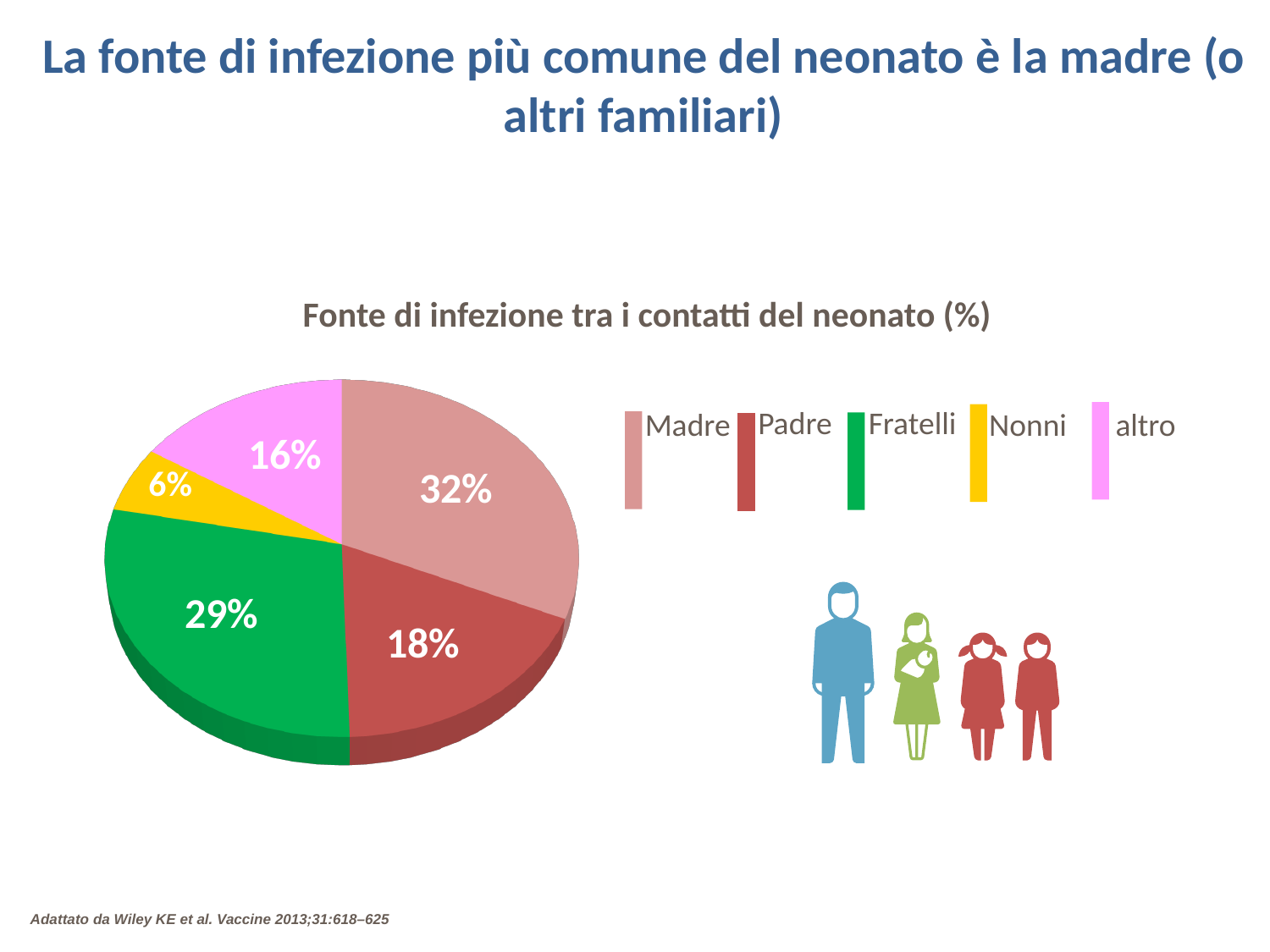
What percentage of the pie is attributed to Madre? 32% What percentage of the pie is attributed to Padre? 18% Which is larger, the share for Fratelli or the share for altro? Fratelli Which category has the largest share of the pie? Madre What type of chart is shown on the slide? Pie chart What percentage of the pie is attributed to Nonni? 6% Which category has the smallest share of the pie? Nonni What percentage of the pie is attributed to altro? 16% What is the chart's title? Fonte di infezione tra i contatti del neonato (%) What is the difference in percentage points between Madre and Padre? 14 How many categories does the pie chart show? 5 What percentage of the pie is attributed to Fratelli? 29%